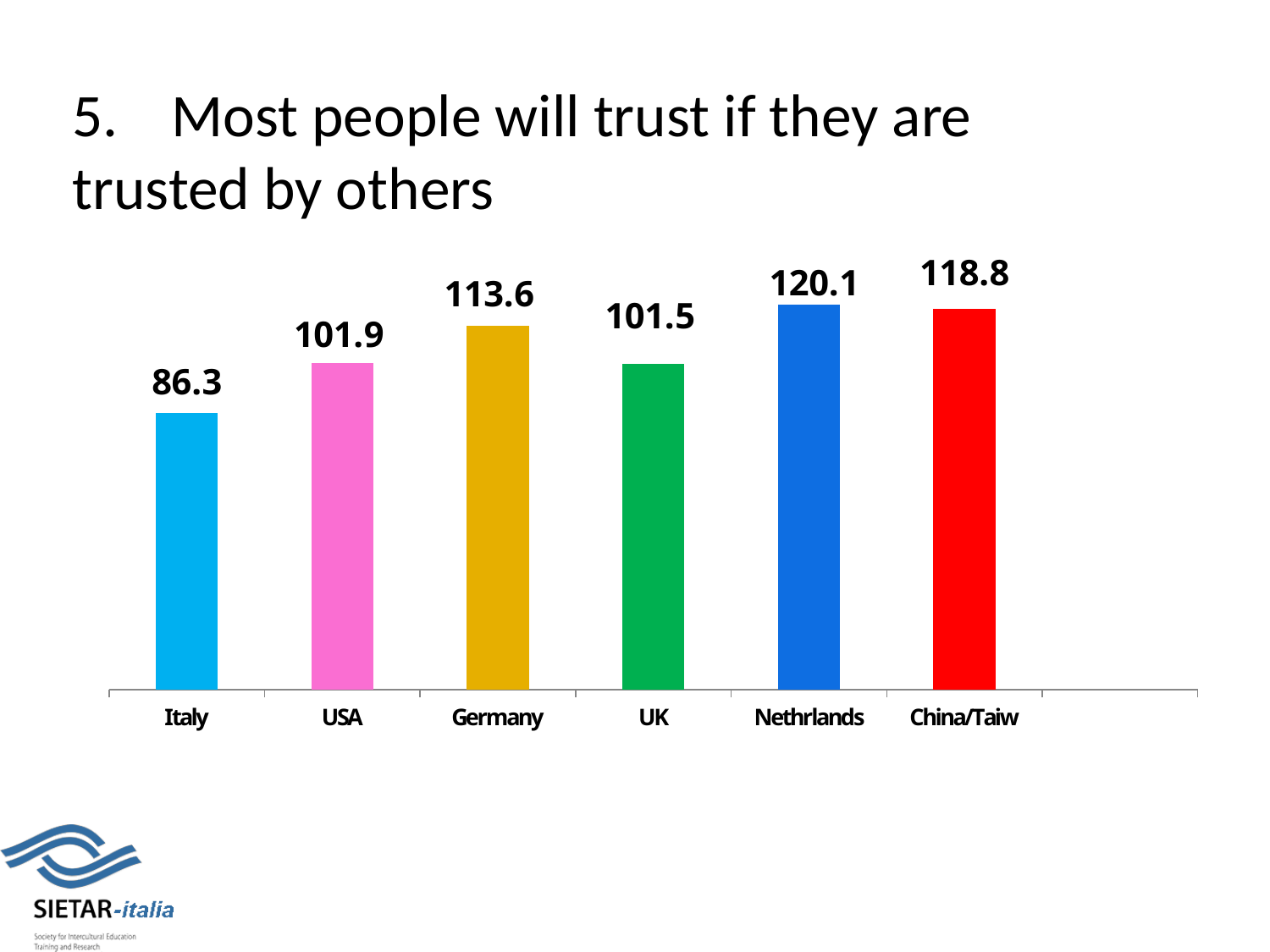
What is the value for Italy? 86.3 What colour is the bar for UK? Green Which is larger, the value for Nethrlands or the value for China/Taiw? Nethrlands What kind of chart is shown on the slide? Bar chart What is the value for China/Taiw? 118.8 What is the difference between the values for Nethrlands and Italy? 33.8 Which category has the highest value? Nethrlands Which is larger, the value for Germany or the value for UK? Germany What is the value for Germany? 113.6 What is the difference between the values for Germany and USA? 11.7 How many categories are shown on the x axis? 6 Which category has the lowest value? Italy